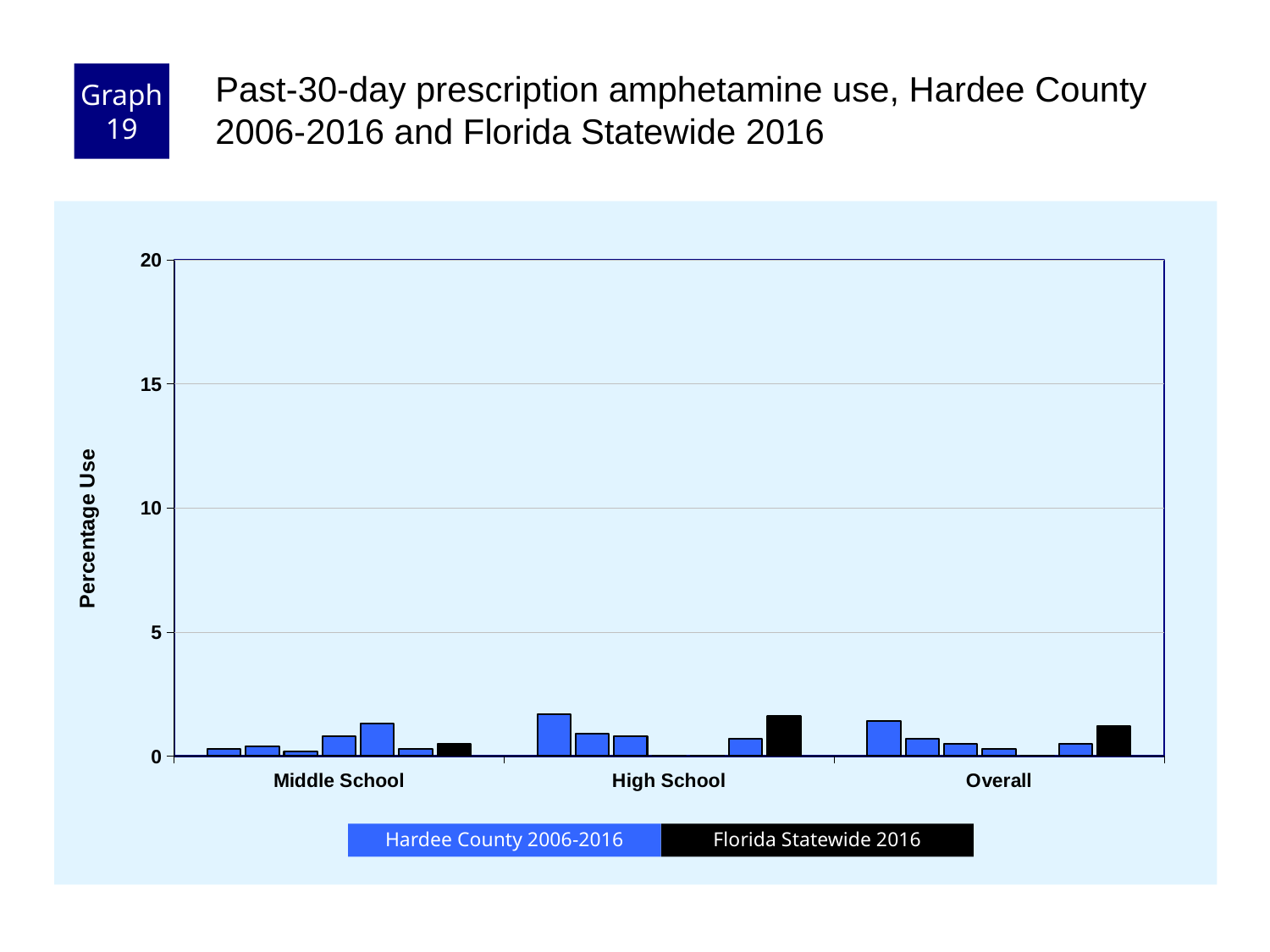
Is the Florida Statewide 2016 value larger for High School or for Middle School? High School For Florida Statewide 2016, which category has the highest value? High School Is the Florida Statewide 2016 value larger for Overall or for Middle School? Overall Is the Florida Statewide 2016 value for Overall greater or less than 10? less What kind of chart is shown on the slide? bar chart How many categories are shown on the x axis? 3 Which series is shown in black in the legend? Florida Statewide 2016 Is the Florida Statewide 2016 value for Middle School greater or less than 5? less What is the label of the y axis? Percentage Use For Florida Statewide 2016, which category has the lowest value? Middle School Is the Florida Statewide 2016 value for High School greater or less than 5? less How many series does the legend list? 2